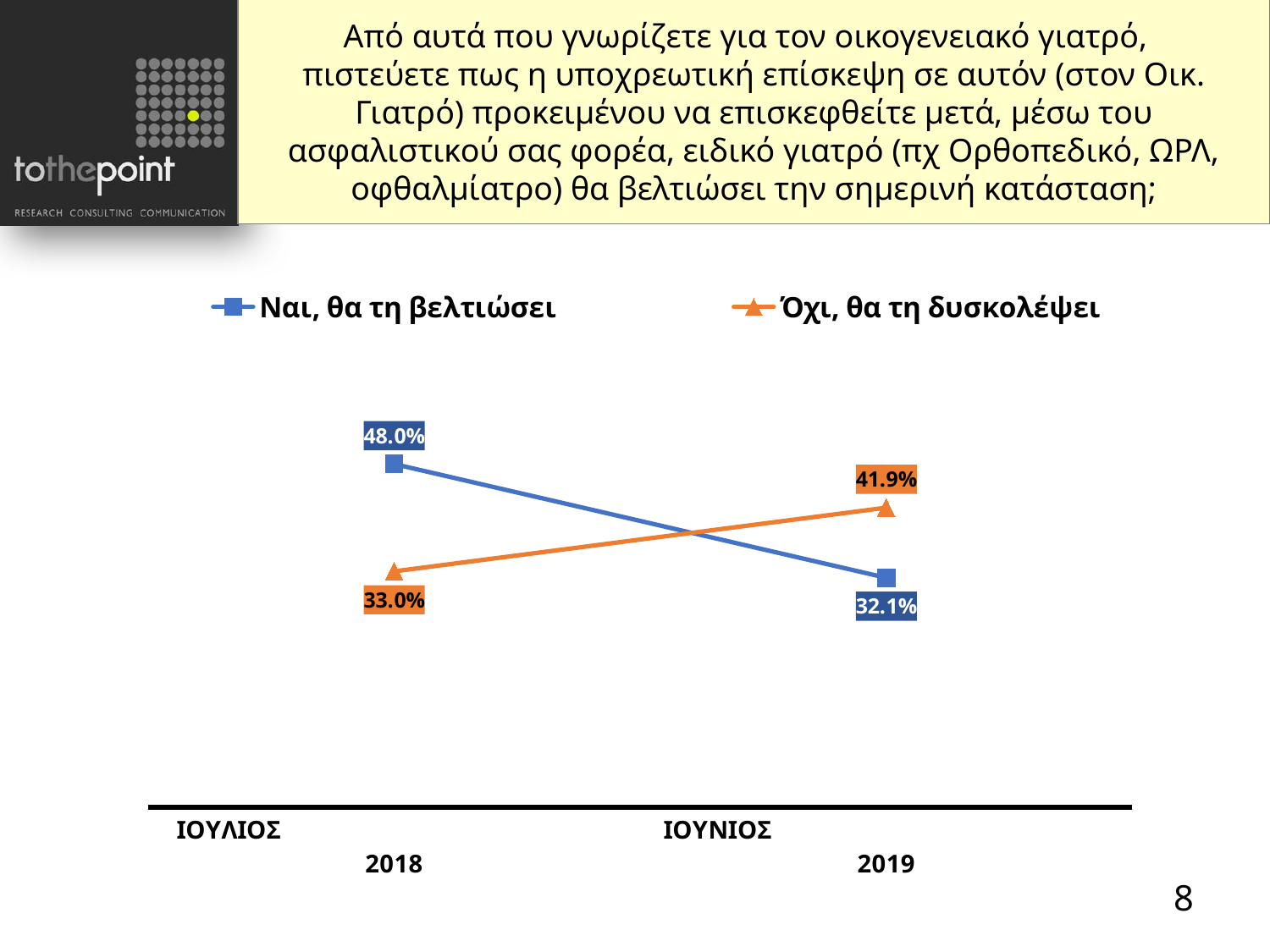
Which colour is used for the "Όχι, θα τη δυσκολέψει" series? orange Does the value for "Όχι, θα τη δυσκολέψει" rise or fall from ΙΟΥΛΙΟΣ 2018 to ΙΟΥΝΙΟΣ 2019? rise What is the value for "Όχι, θα τη δυσκολέψει" in ΙΟΥΛΙΟΣ 2018? 33.0% How many time points are plotted on the x axis? 2 By how much did the value for "Ναι, θα τη βελτιώσει" change between ΙΟΥΛΙΟΣ 2018 and ΙΟΥΝΙΟΣ 2019? 15.9 percentage points What kind of chart is shown on the slide? line chart What is the value for "Ναι, θα τη βελτιώσει" in ΙΟΥΝΙΟΣ 2019? 32.1% Which series has the higher value in ΙΟΥΝΙΟΣ 2019? Όχι, θα τη δυσκολέψει What is the value for "Όχι, θα τη δυσκολέψει" in ΙΟΥΝΙΟΣ 2019? 41.9% Does the value for "Ναι, θα τη βελτιώσει" rise or fall from ΙΟΥΛΙΟΣ 2018 to ΙΟΥΝΙΟΣ 2019? fall What is the value for "Ναι, θα τη βελτιώσει" in ΙΟΥΛΙΟΣ 2018? 48.0% How many series does the legend list? 2